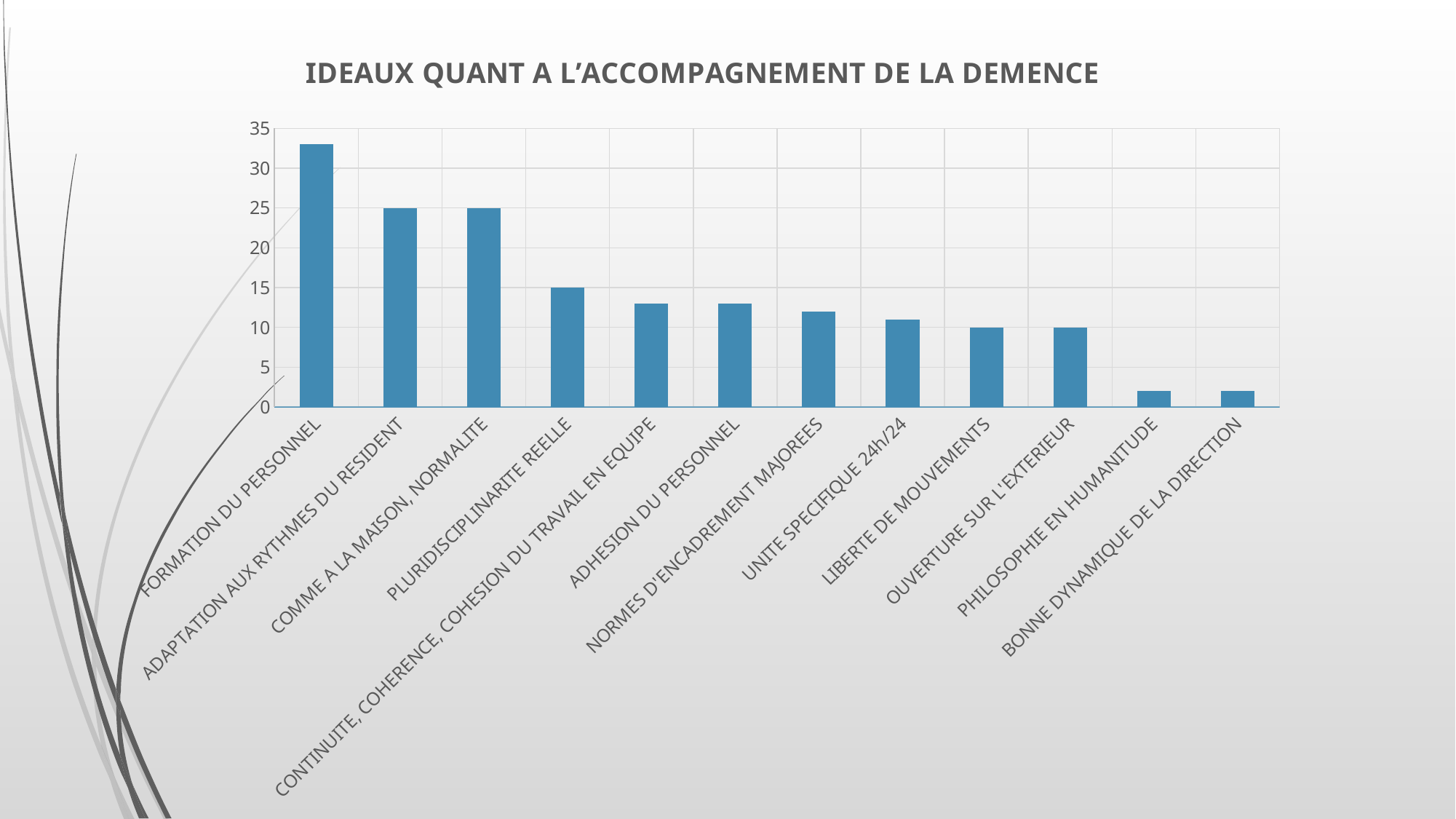
What is the value for LIBERTE DE MOUVEMENTS? 10 How many categories are plotted in the chart? 12 Is the value for PHILOSOPHIE EN HUMANITUDE greater or less than 5? less Do the values generally rise or fall from left to right along the x axis? fall What is the value for ADAPTATION AUX RYTHMES DU RESIDENT? 25 Which category has the highest value? FORMATION DU PERSONNEL What is the title of the chart? IDEAUX QUANT A L'ACCOMPAGNEMENT DE LA DEMENCE What is the value for PLURIDISCIPLINARITE REELLE? 15 What is the difference between the values for ADAPTATION AUX RYTHMES DU RESIDENT and PLURIDISCIPLINARITE REELLE? 10 Is the value for ADHESION DU PERSONNEL greater or less than 15? less Is the value for FORMATION DU PERSONNEL greater or less than 30? greater What type of chart is shown on the slide? bar chart